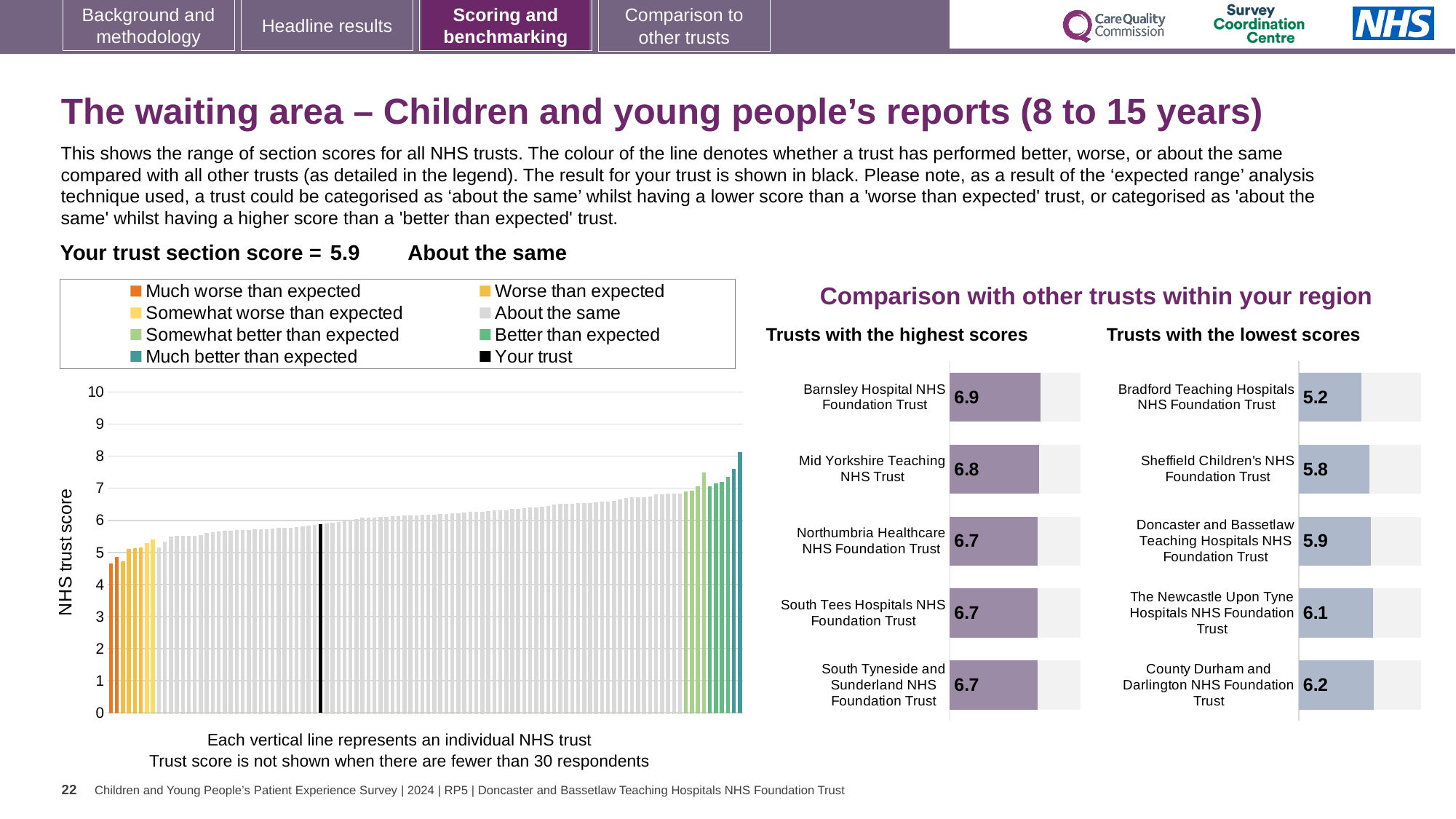
In the 'Trusts with the highest scores' chart, what is the difference between the scores of Barnsley Hospital NHS Foundation Trust and Mid Yorkshire Teaching NHS Trust? 0.1 In the 'Trusts with the lowest scores' chart, what is the difference between the scores of County Durham and Darlington NHS Foundation Trust and Bradford Teaching Hospitals NHS Foundation Trust? 1.0 In the 'Trusts with the highest scores' chart, which trust has the highest score? Barnsley Hospital NHS Foundation Trust In the 'Trusts with the highest scores' chart, how many trusts are shown? 5 In the NHS trust score chart on the left, is the value of the lowest (leftmost) bar greater or less than 5? less In the 'Trusts with the highest scores' chart, what is the score for Barnsley Hospital NHS Foundation Trust? 6.9 In the 'Trusts with the lowest scores' chart, what is the score for Bradford Teaching Hospitals NHS Foundation Trust? 5.2 In the 'Trusts with the lowest scores' chart, what is the score for Doncaster and Bassetlaw Teaching Hospitals NHS Foundation Trust? 5.9 How many entries does the legend of the NHS trust score chart on the left list? 8 In the 'Trusts with the lowest scores' chart, which has the higher score: The Newcastle Upon Tyne Hospitals NHS Foundation Trust or Sheffield Children's NHS Foundation Trust? The Newcastle Upon Tyne Hospitals NHS Foundation Trust In the 'Trusts with the lowest scores' chart, which trust has the lowest score? Bradford Teaching Hospitals NHS Foundation Trust In the NHS trust score chart on the left, do the bar values rise or fall from left to right? rise